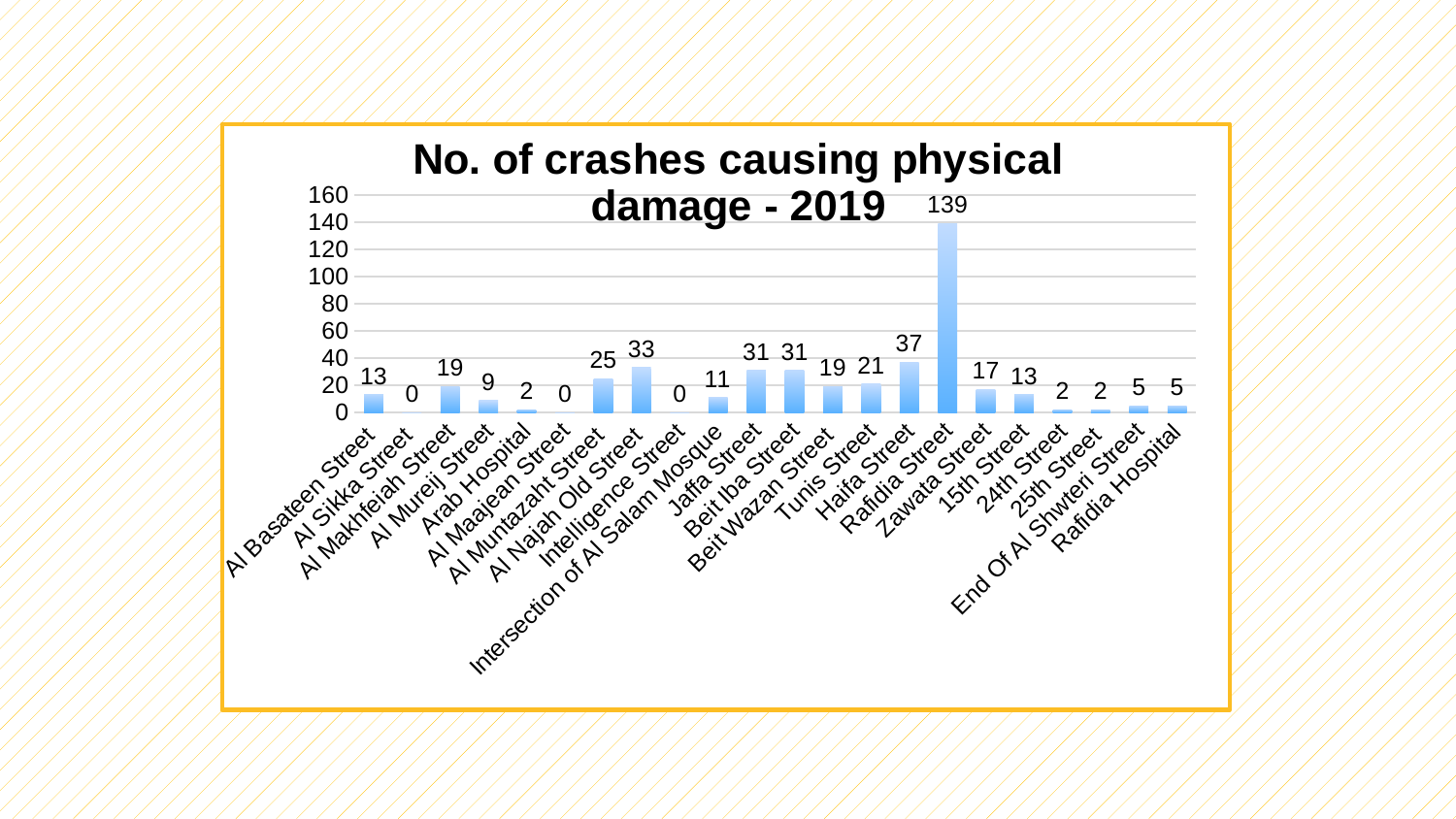
How many locations are shown on the x axis of the chart? 22 What is the title of the chart? No. of crashes causing physical damage - 2019 What is the value shown for Intersection of Al Salam Mosque? 11 What kind of chart is shown on the slide? Bar chart What is the difference between the values for Al Muntazaht Street and Al Mureij Street? 16 What is the difference between the values for Rafidia Street and Haifa Street? 102 What is the value shown for Haifa Street? 37 Is the value for Rafidia Street greater or less than 120? greater What is the number of crashes causing physical damage for Rafidia Street? 139 Which has a larger value, Tunis Street or Zawata Street? Tunis Street What is the value shown for Al Najah Old Street? 33 Which location has the highest number of crashes causing physical damage? Rafidia Street